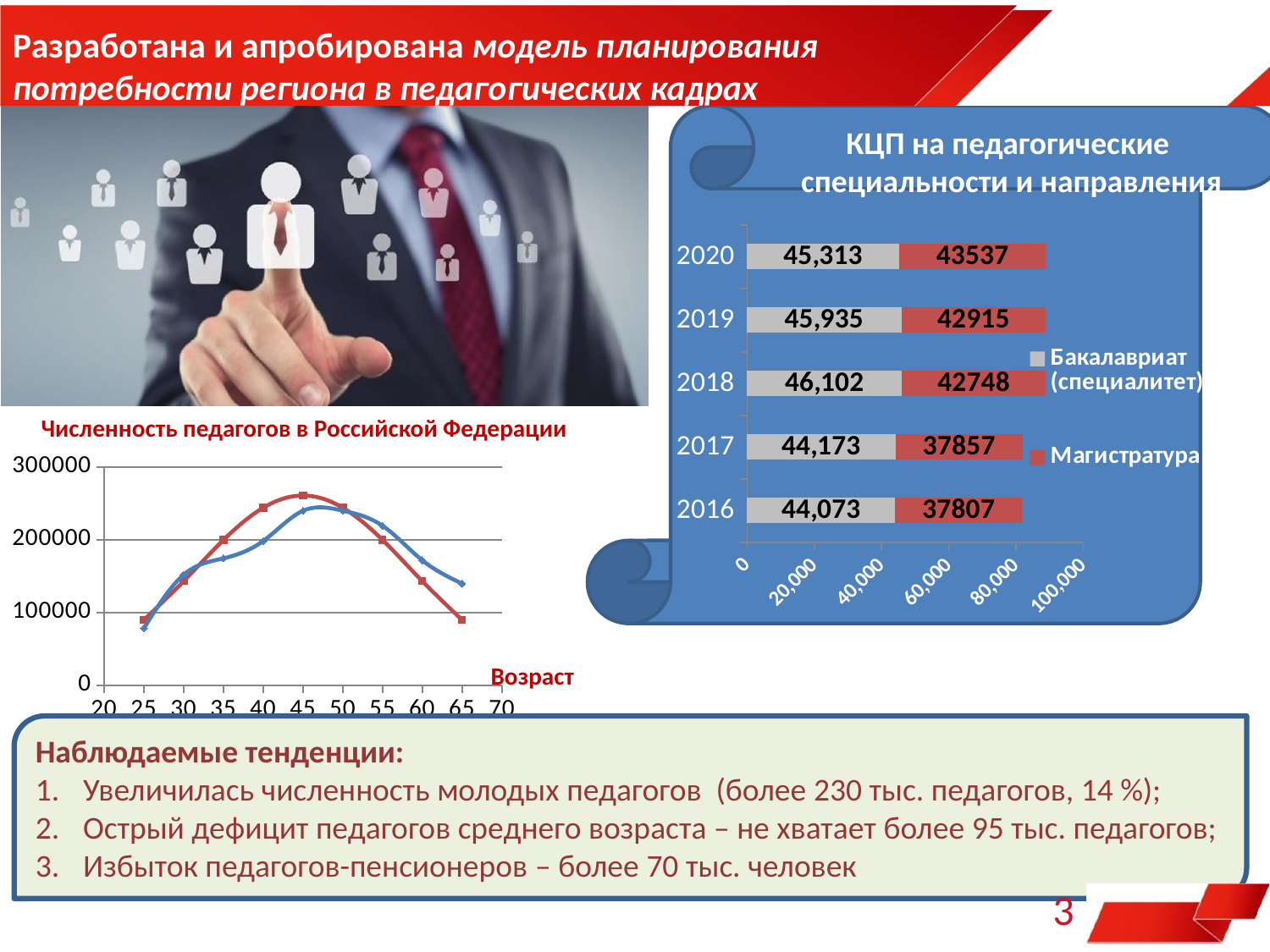
What kind of chart is 'Численность педагогов в Российской Федерации'? Line chart In the chart 'КЦП на педагогические специальности и направления', what is the difference between the Магистратура values for 2020 and 2016? 5730 How many series does the legend of the chart 'КЦП на педагогические специальности и направления' list? 2 In the chart 'КЦП на педагогические специальности и направления', what is the value for Бакалавриат (специалитет) in 2020? 45,313 What kind of chart is 'КЦП на педагогические специальности и направления'? Stacked bar chart In the chart 'КЦП на педагогические специальности и направления', what is the value for Магистратура in 2017? 37857 In the chart 'КЦП на педагогические специальности и направления', which is larger: Бакалавриат (специалитет) in 2019 or Магистратура in 2019? Бакалавриат (специалитет) In the chart 'КЦП на педагогические специальности и направления', what is the total of the stacked bar for 2020? 88850 In the chart 'Численность педагогов в Российской Федерации', do the values rise or fall from age 25 to age 45? rise In the chart 'КЦП на педагогические специальности и направления', which year has the lowest value for Магистратура? 2016 In the chart 'КЦП на педагогические специальности и направления', which year has the highest value for Бакалавриат (специалитет)? 2018 In the chart 'Численность педагогов в Российской Федерации', is the value of the red line at age 45 greater or less than 200000? greater